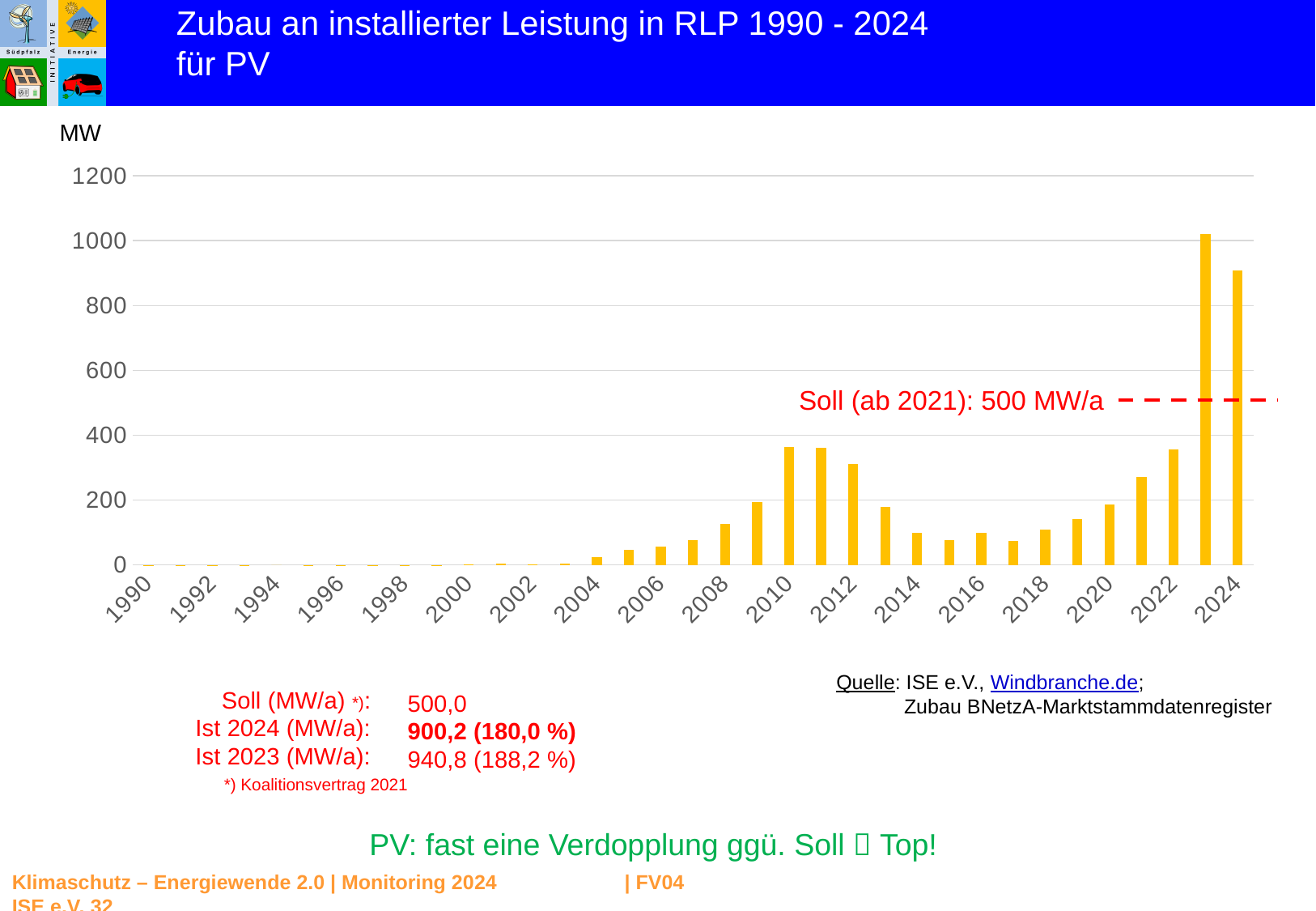
Which year has the larger value, 2023 or 2024? 2023 Is the value for 2024 greater or less than 800? greater Which year has the highest PV capacity addition in the chart? 2023 Is the value for 2010 greater or less than 400? less According to the slide, what is the Ist 2023 value in MW/a? 940,8 Do the values rise or fall from 2016 to 2023? rise What kind of chart is shown on the slide? bar chart Is the value for 2014 greater or less than 200? less What is the difference between the Ist 2023 and Ist 2024 values in MW/a? 40,6 Which year has the larger value, 2020 or 2021? 2021 What target value (Soll) is marked by the dashed line from 2021 onwards? 500 MW/a According to the slide, what is the Ist 2024 value in MW/a? 900,2